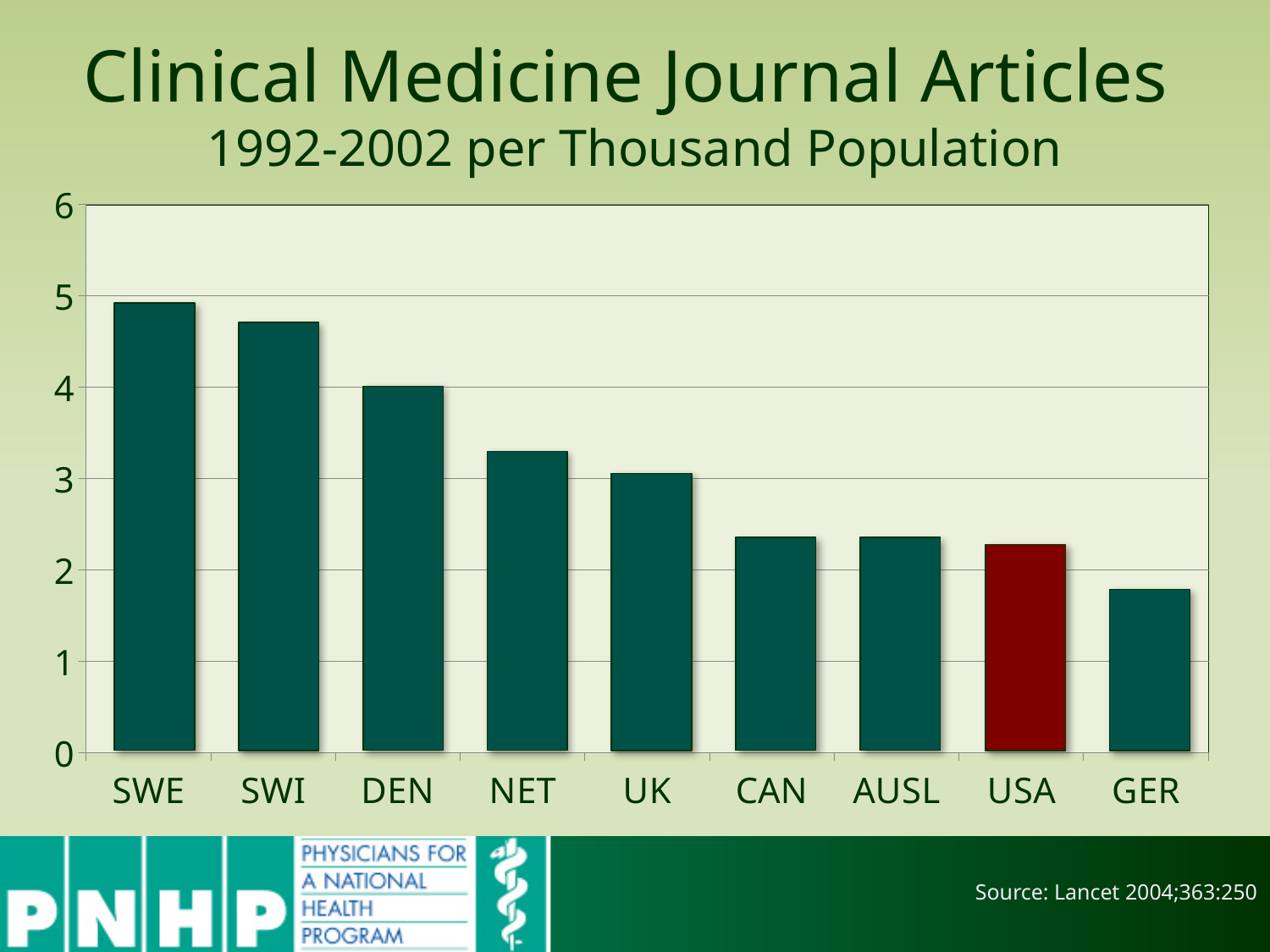
Do the values rise or fall moving from left to right along the x axis? fall Is the value for USA greater or less than 2? greater Which country has the highest number of clinical medicine journal articles per thousand population? SWE Which country's bar is coloured red rather than dark green? USA Is the value for SWI greater or less than 5? less Is the value for SWE greater or less than 4? greater Which has a higher value, USA or GER? USA What kind of chart is shown on the slide? bar chart How many countries are shown on the x axis of the chart? 9 Which country has the lowest number of clinical medicine journal articles per thousand population? GER